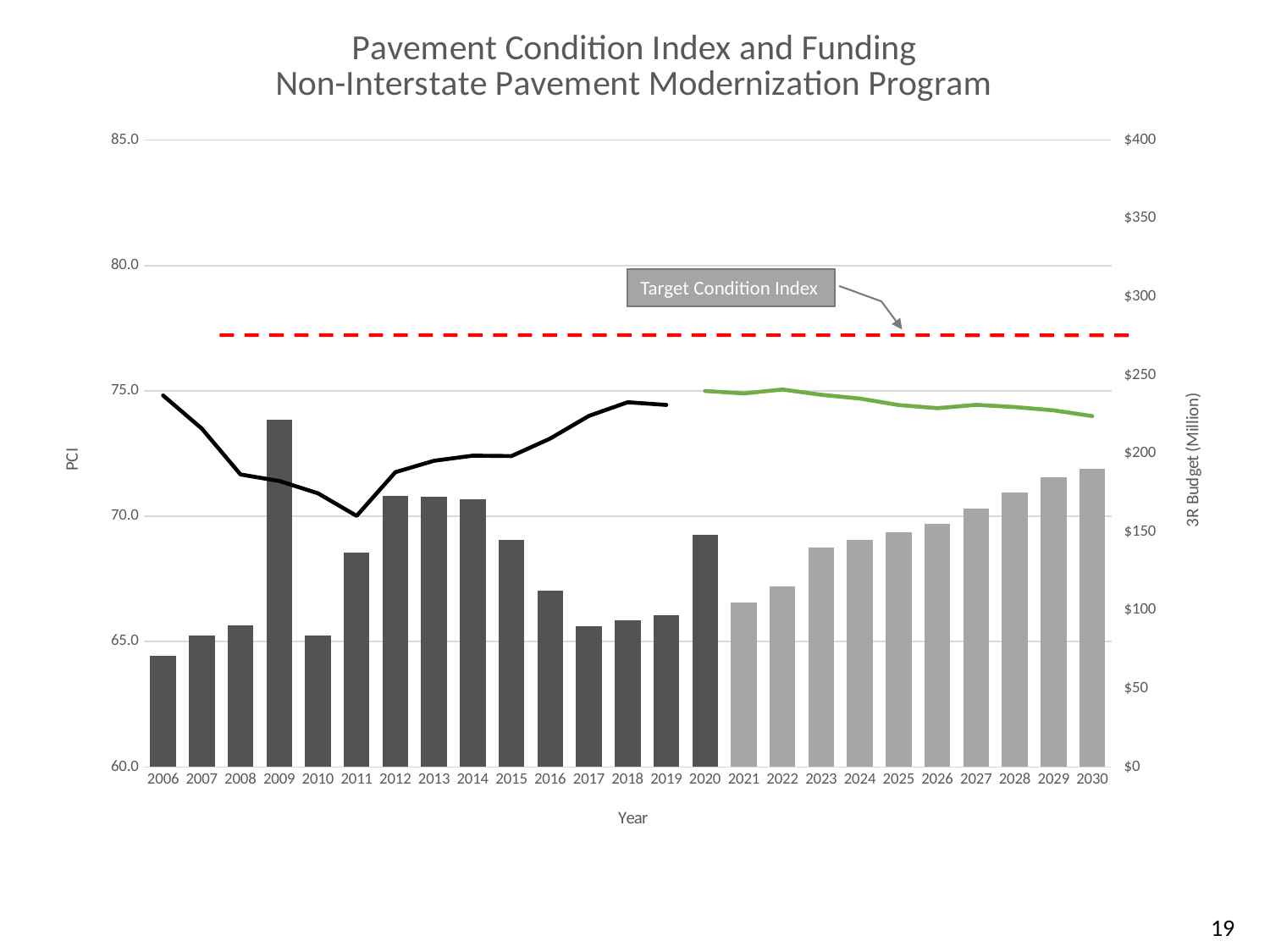
Does the black PCI line rise or fall from 2006 to 2011? fall Is the 3R Budget bar for 2009 greater or less than $200 million? greater Which year has the tallest 3R Budget bar? 2009 Is the 3R Budget bar for 2006 greater or less than $100 million? less How many years are shown along the x axis of the chart? 25 Is the Target Condition Index dashed line greater or less than 75 on the PCI axis? greater Do the 3R Budget bars rise or fall from 2021 to 2030? rise Which year has the larger 3R Budget bar, 2009 or 2012? 2009 What is the title of the right-hand vertical axis? 3R Budget (Million) Which year has the shortest 3R Budget bar? 2006 What type of chart is shown on the slide? Combination bar and line chart